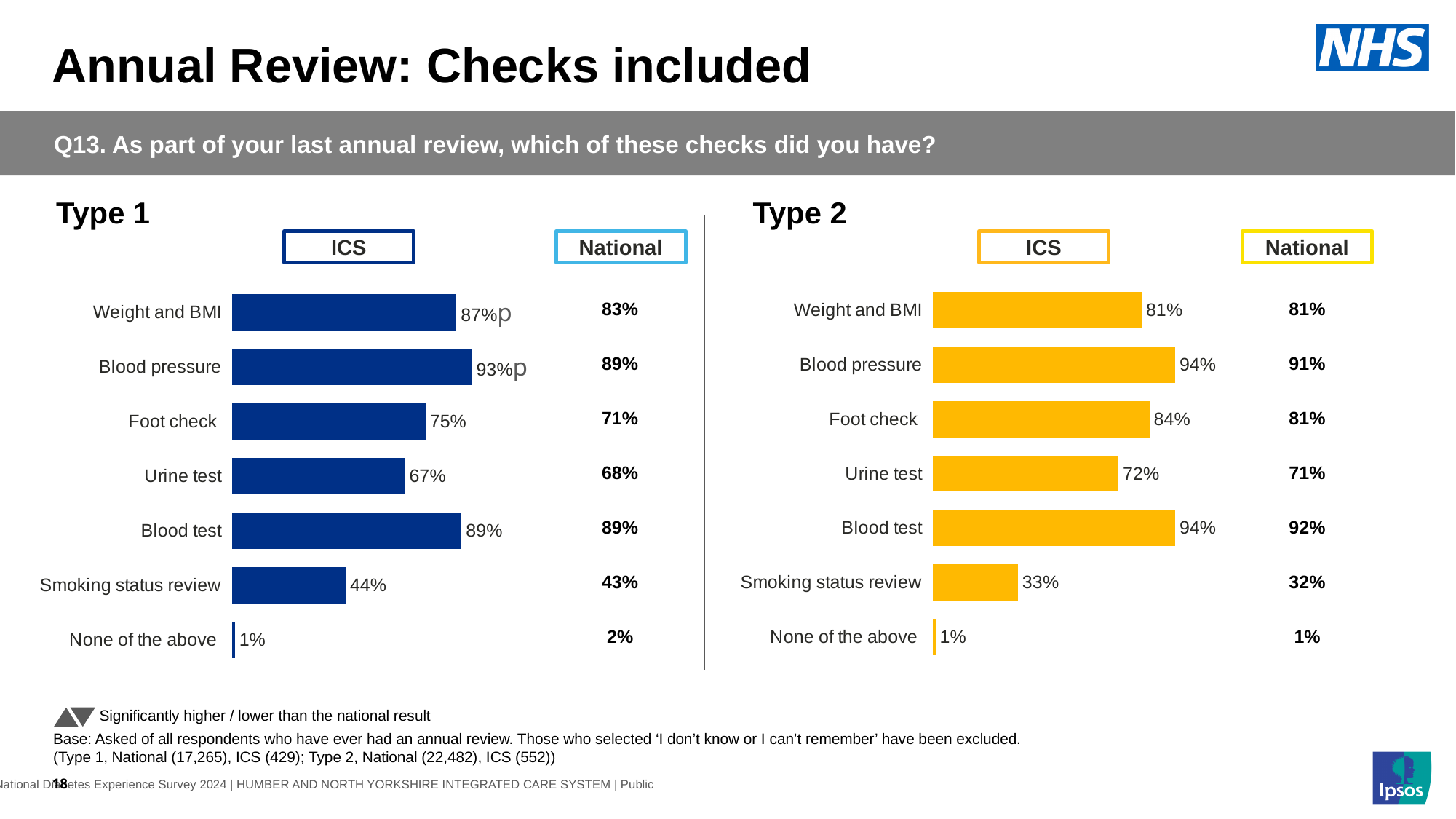
In the Type 1 chart, which check has the highest ICS value? Blood pressure In the Type 2 chart, which is larger for Foot check: the ICS value or the National value? ICS In the Type 1 chart, what is the difference between the ICS and National values for Weight and BMI? 4 percentage points What type of chart is used for the Type 2 ICS results? Bar chart How many checks are listed in the Type 1 chart? 7 In the Type 2 chart, what is the ICS value for Smoking status review? 33% What colour are the ICS bars in the Type 1 chart? Dark blue In the Type 1 chart, what is the National value for Urine test? 68% In the Type 2 chart, what is the National value for Blood test? 92% In the Type 2 chart, what is the difference between the ICS values for Blood pressure and Urine test? 22 percentage points In the Type 1 chart, what is the ICS value for Foot check? 75% In the Type 2 chart, which check has the lowest ICS value? None of the above